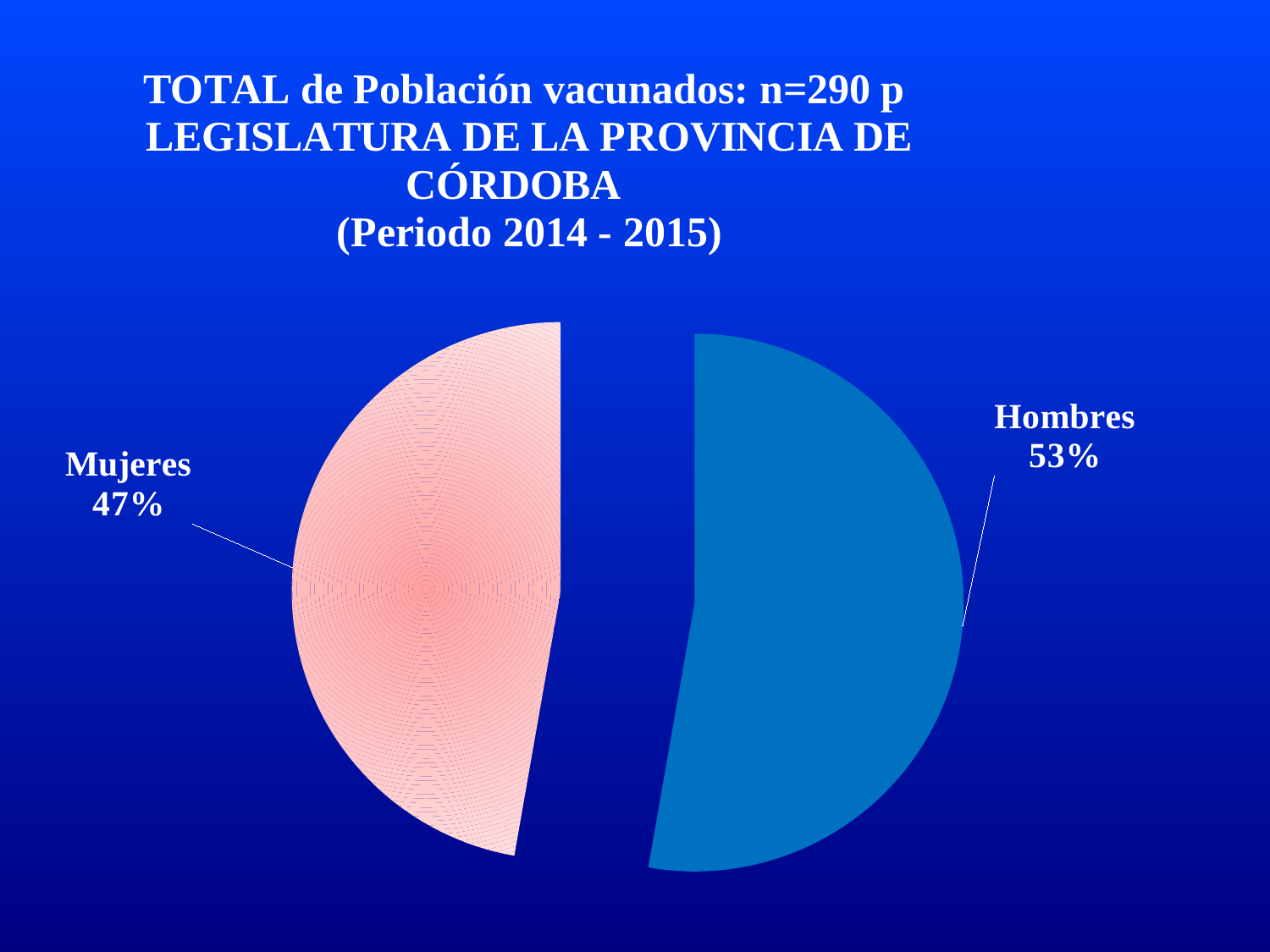
What percentage of the vaccinated population is Hombres? 53% Which category has the smallest slice of the pie? Mujeres What kind of chart is shown on the slide? Pie chart What is the difference in percentage points between the Hombres and Mujeres slices? 6 Which category has the largest slice of the pie? Hombres What period does the chart title say the data covers? 2014 - 2015 What is the total number of vaccinated people (n) stated in the chart title? 290 What percentage of the vaccinated population is Mujeres? 47% How many slices does the pie chart have? 2 Which group has the larger share of the pie, Mujeres or Hombres? Hombres